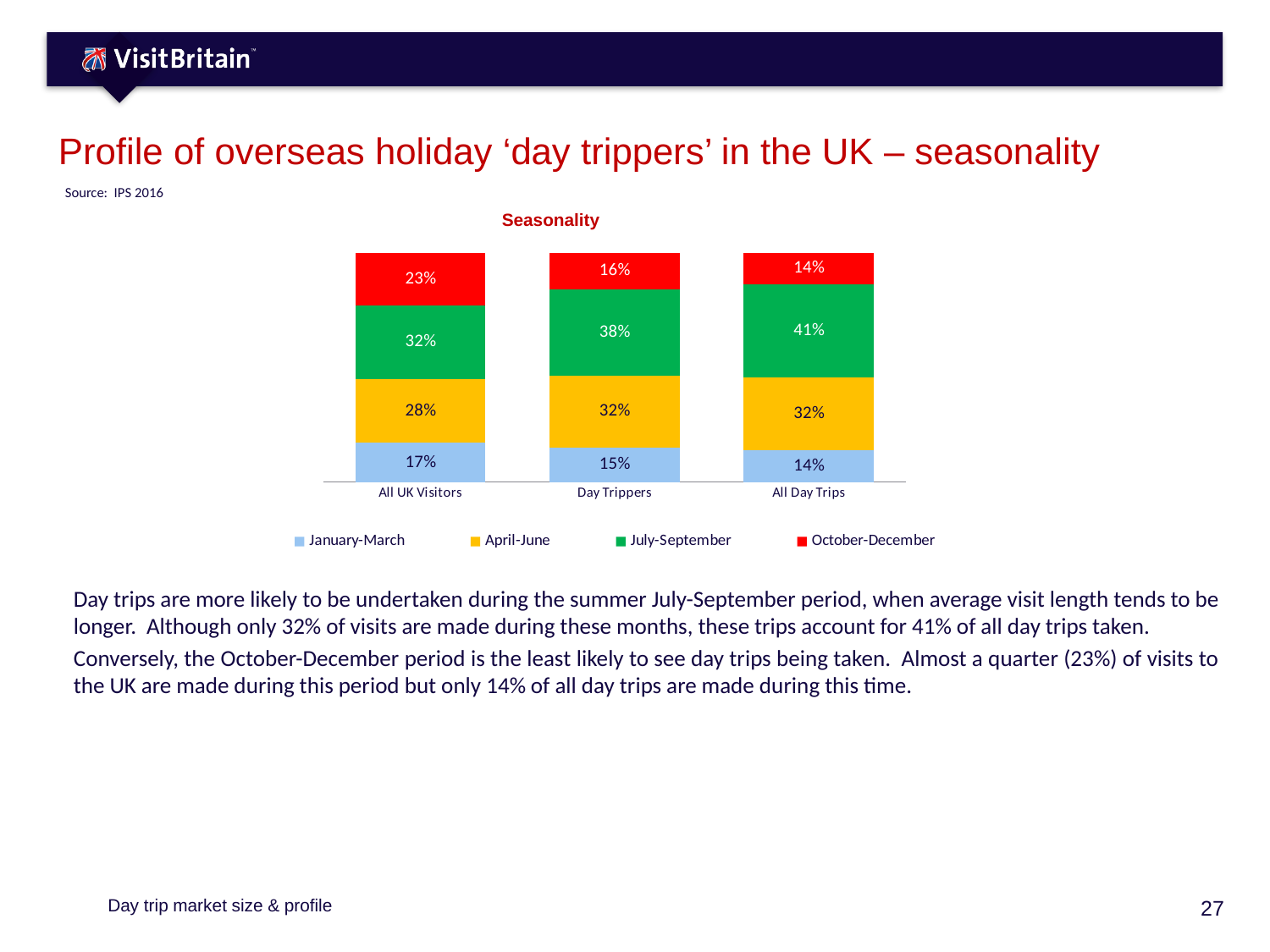
What kind of chart is shown? Stacked bar chart What is the difference between the October-December values for All UK Visitors and All Day Trips? 9% Which is larger: the July-September value for All UK Visitors or for Day Trippers? Day Trippers What is the title of the chart? Seasonality Which category has the lowest October-December value? All Day Trips What is the January-March value for All Day Trips? 14% What is the July-September value for Day Trippers? 38% What is the October-December value for All UK Visitors? 23% How many series does the legend list? 4 Which category has the highest July-September value? All Day Trips What is the April-June value for Day Trippers? 32% How many categories are shown on the x axis? 3